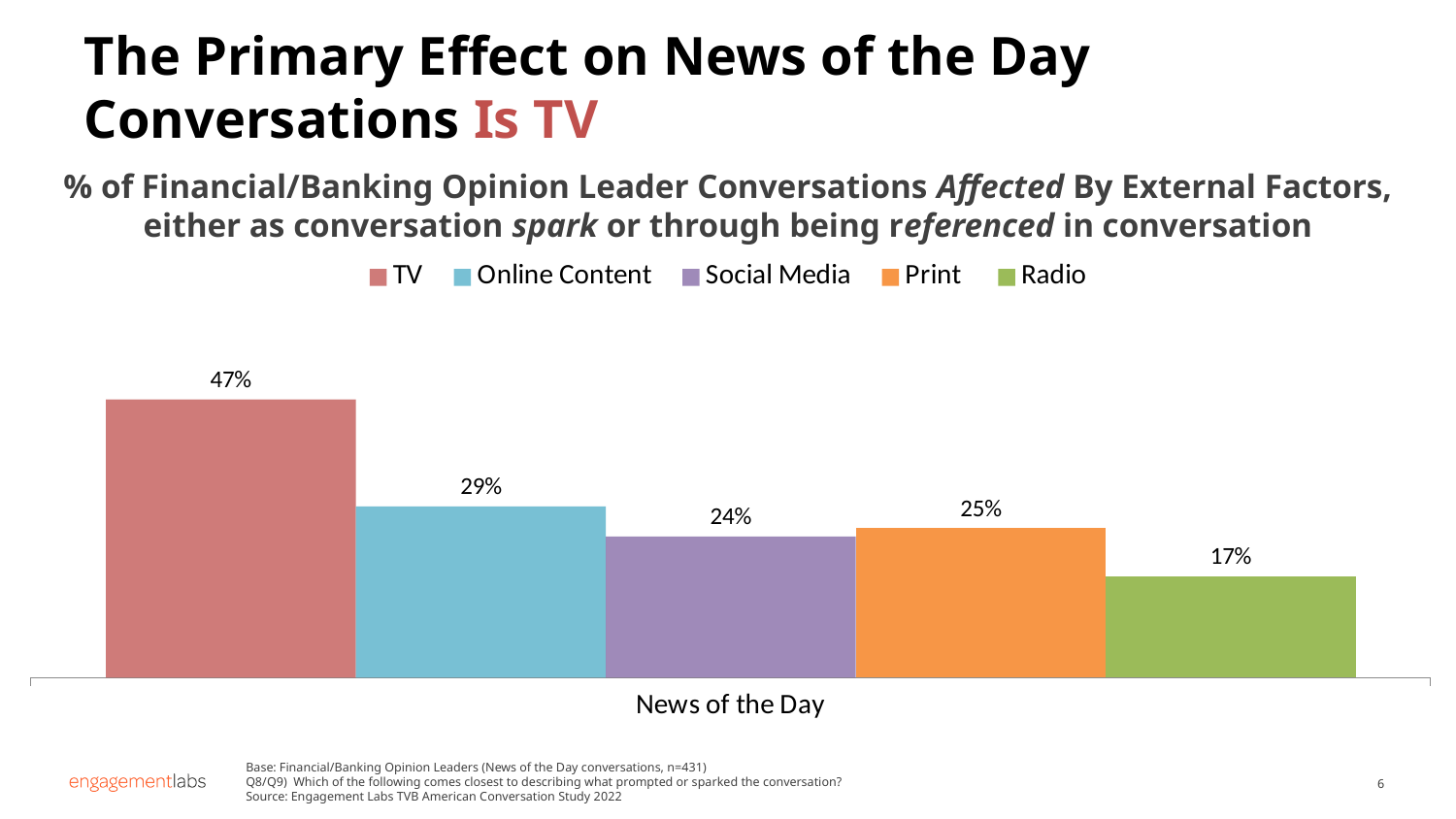
What percentage of News of the Day conversations were affected by TV? 47% Which external factor has the lowest value? Radio What is the value for Online Content? 29% What is the difference between the TV value and the Online Content value? 18% What is the category label shown on the x axis? News of the Day What kind of chart is shown on the slide? Bar chart Which is larger, the value for Print or the value for Social Media? Print What is the value for Radio? 17% What is the difference between the Print value and the Radio value? 8% What is the value for Social Media? 24% How many series does the legend list? 5 Which external factor has the highest value? TV